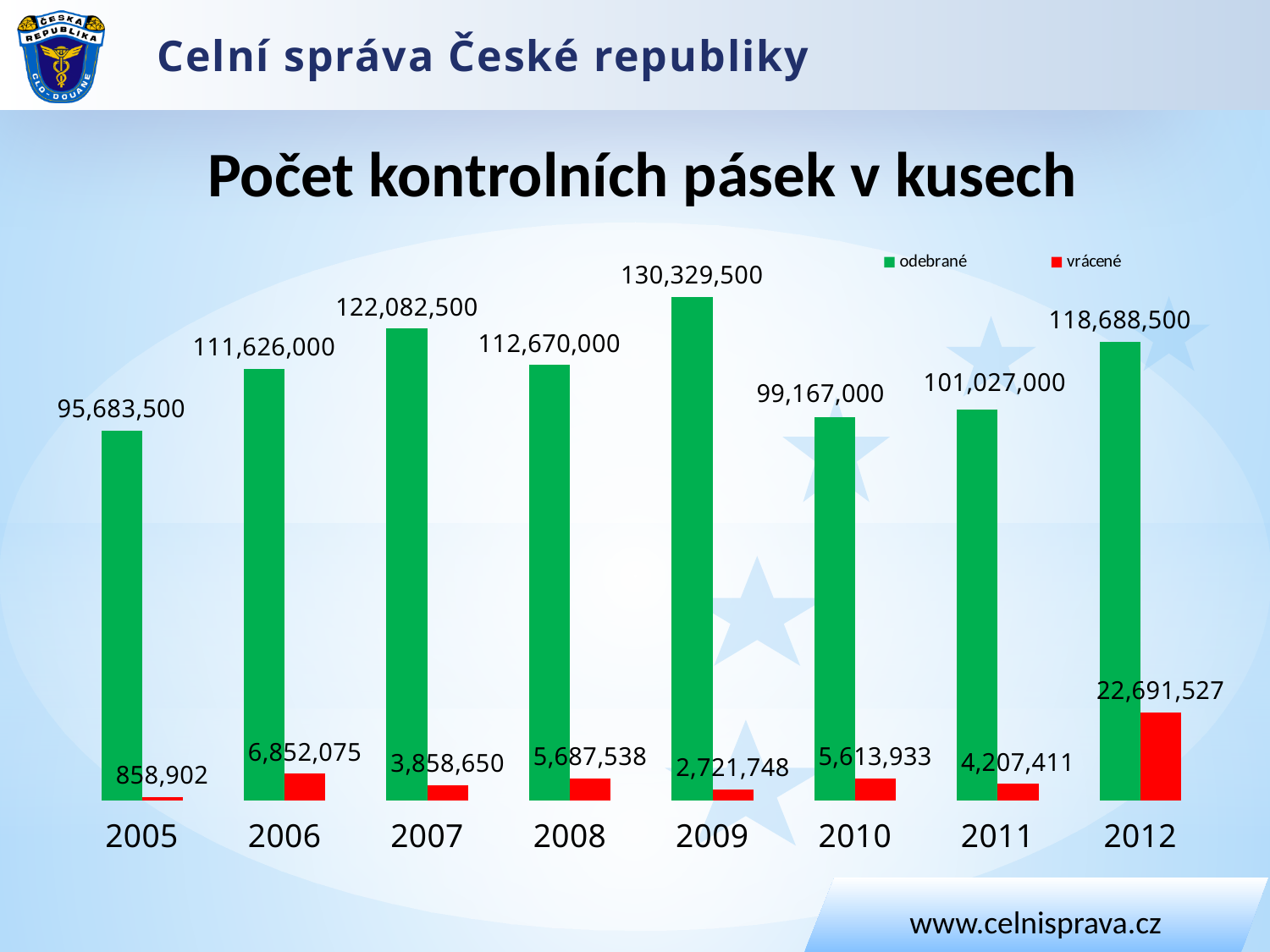
What is the value of odebrané for 2009? 130,329,500 Which is larger, the odebrané value for 2007 or for 2012? 2007 What is the value of vrácené for 2005? 858,902 Which year has the lowest vrácené value? 2005 What is the value of odebrané for 2011? 101,027,000 Which year has the highest odebrané value? 2009 What is the difference between the vrácené values for 2012 and 2006? 15,839,452 What type of chart is shown on the slide? bar chart How many series does the legend list? 2 What is the difference between the odebrané values for 2009 and 2005? 34,646,000 What is the value of vrácené for 2012? 22,691,527 How many years are shown on the x axis? 8